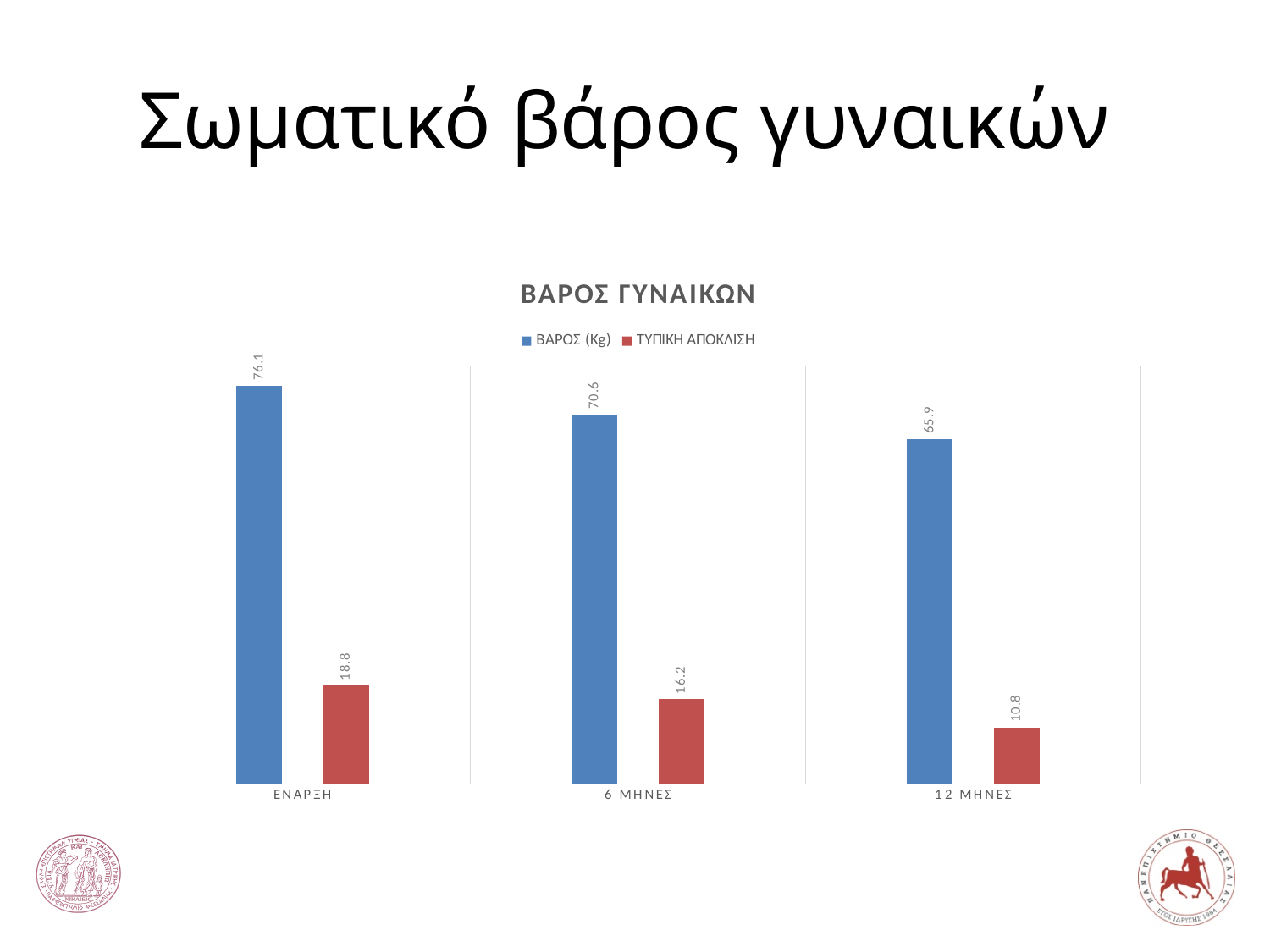
What kind of chart is shown? Bar chart What is the difference between the ΒΑΡΟΣ (Kg) values for ΕΝΑΡΞΗ and 12 ΜΗΝΕΣ? 10.2 Do the ΒΑΡΟΣ (Kg) values rise or fall from ΕΝΑΡΞΗ to 12 ΜΗΝΕΣ? Fall Which category has the highest ΒΑΡΟΣ (Kg) value? ΕΝΑΡΞΗ What is the ΒΑΡΟΣ (Kg) value for ΕΝΑΡΞΗ? 76.1 How many series does the legend list? 2 Which category has the lowest ΤΥΠΙΚΗ ΑΠΟΚΛΙΣΗ value? 12 ΜΗΝΕΣ What is the ΒΑΡΟΣ (Kg) value for 6 ΜΗΝΕΣ? 70.6 What is the difference between the ΤΥΠΙΚΗ ΑΠΟΚΛΙΣΗ values for ΕΝΑΡΞΗ and 6 ΜΗΝΕΣ? 2.6 What is the ΤΥΠΙΚΗ ΑΠΟΚΛΙΣΗ value for 12 ΜΗΝΕΣ? 10.8 How many categories are shown on the x axis? 3 Which is larger, the ΒΑΡΟΣ (Kg) value for 6 ΜΗΝΕΣ or for 12 ΜΗΝΕΣ? 6 ΜΗΝΕΣ